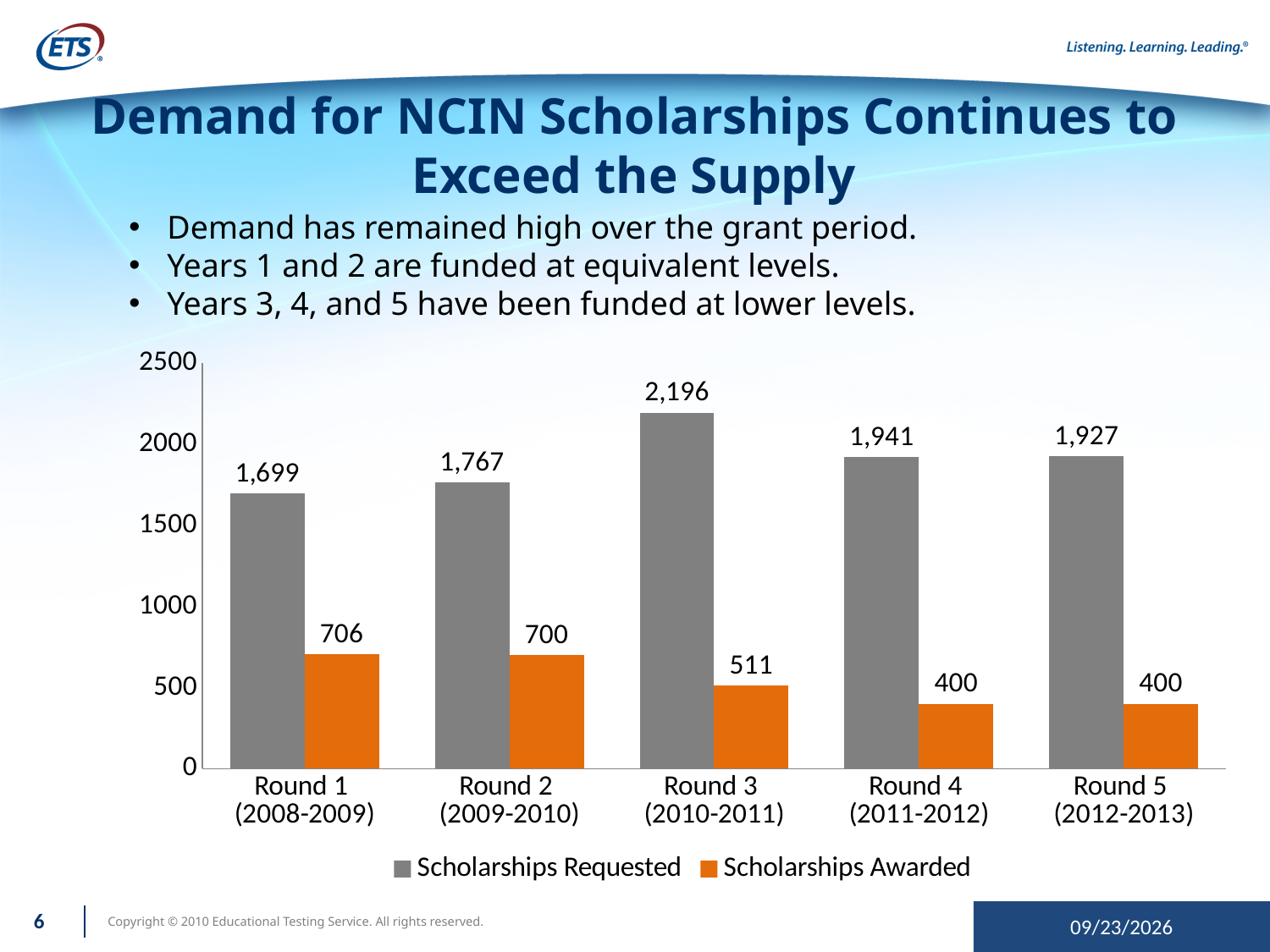
Which is larger: Scholarships Requested in Round 4 (2011-2012) or in Round 2 (2009-2010)? Round 4 (2011-2012) How many rounds are shown on the x axis of the chart? 5 How many Scholarships Requested were there in Round 3 (2010-2011)? 2,196 What is the difference in Scholarships Awarded between Round 1 (2008-2009) and Round 4 (2011-2012)? 306 How many series does the chart legend list? 2 How many Scholarships Awarded were there in Round 1 (2008-2009)? 706 How many Scholarships Awarded were there in Round 5 (2012-2013)? 400 What is the difference between Scholarships Requested and Scholarships Awarded in Round 3 (2010-2011)? 1,685 Which round had the highest number of Scholarships Requested? Round 3 (2010-2011) What kind of chart is shown on the slide? Bar chart Which round had the lowest number of Scholarships Requested? Round 1 (2008-2009) Is the value for Scholarships Awarded in Round 3 (2010-2011) greater or less than 500? greater